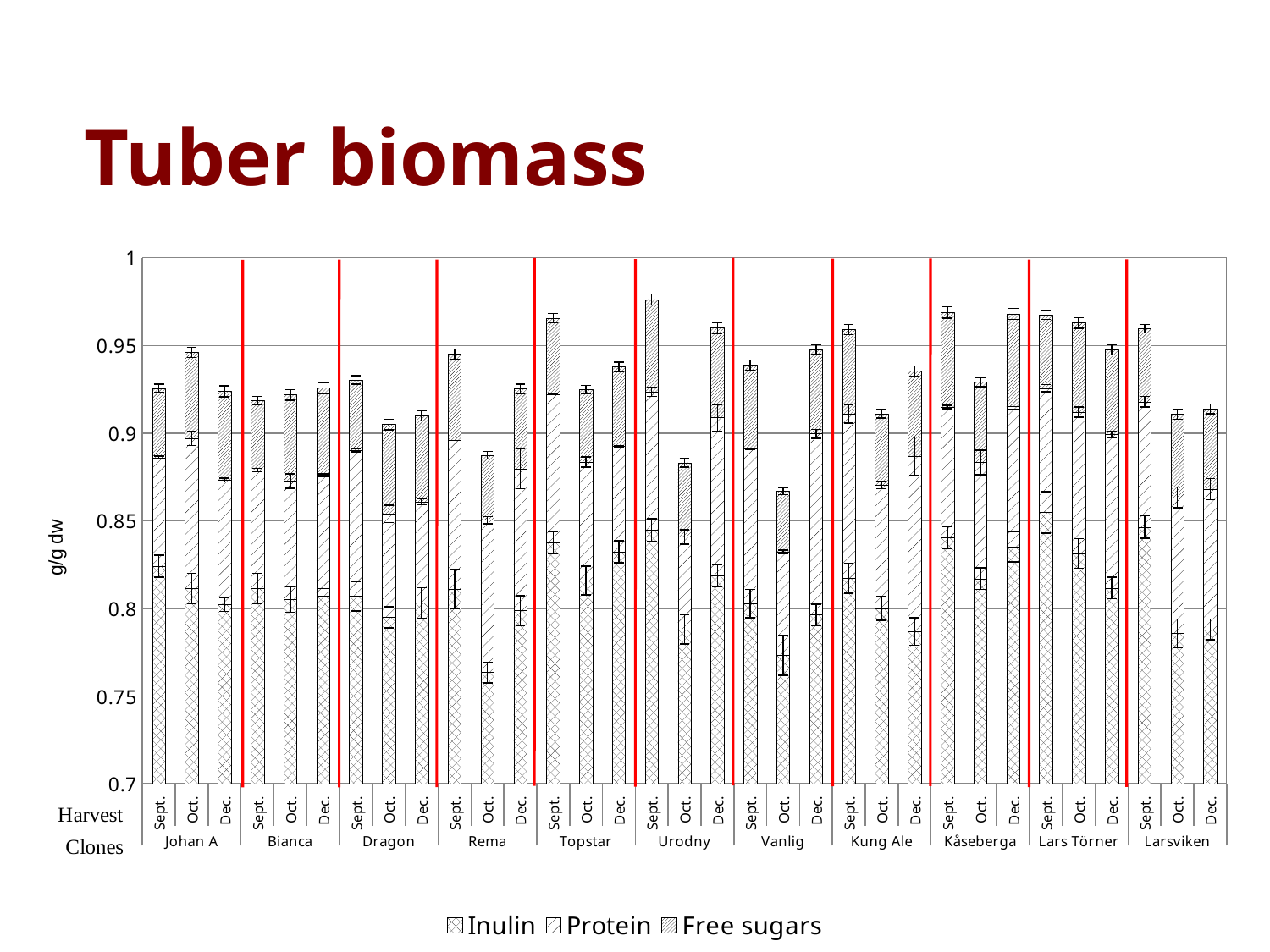
Which harvest has the lowest total bar for the Vanlig clone? Oct. What is the label of the y axis? g/g dw What kind of chart is shown on the slide? Stacked bar chart Is the total bar height for Urodny Sept. greater or less than 0.95? greater For the Urodny clone, which total bar is taller, Sept. or Oct.? Sept. How many clones are shown along the x axis? 11 How many harvest dates are shown for each clone? 3 Is the total bar height for Rema Oct. greater or less than 0.9? less Which series are listed in the legend? Inulin, Protein, Free sugars How many series does the legend list? 3 Is the total bar height for Vanlig Oct. greater or less than 0.9? less